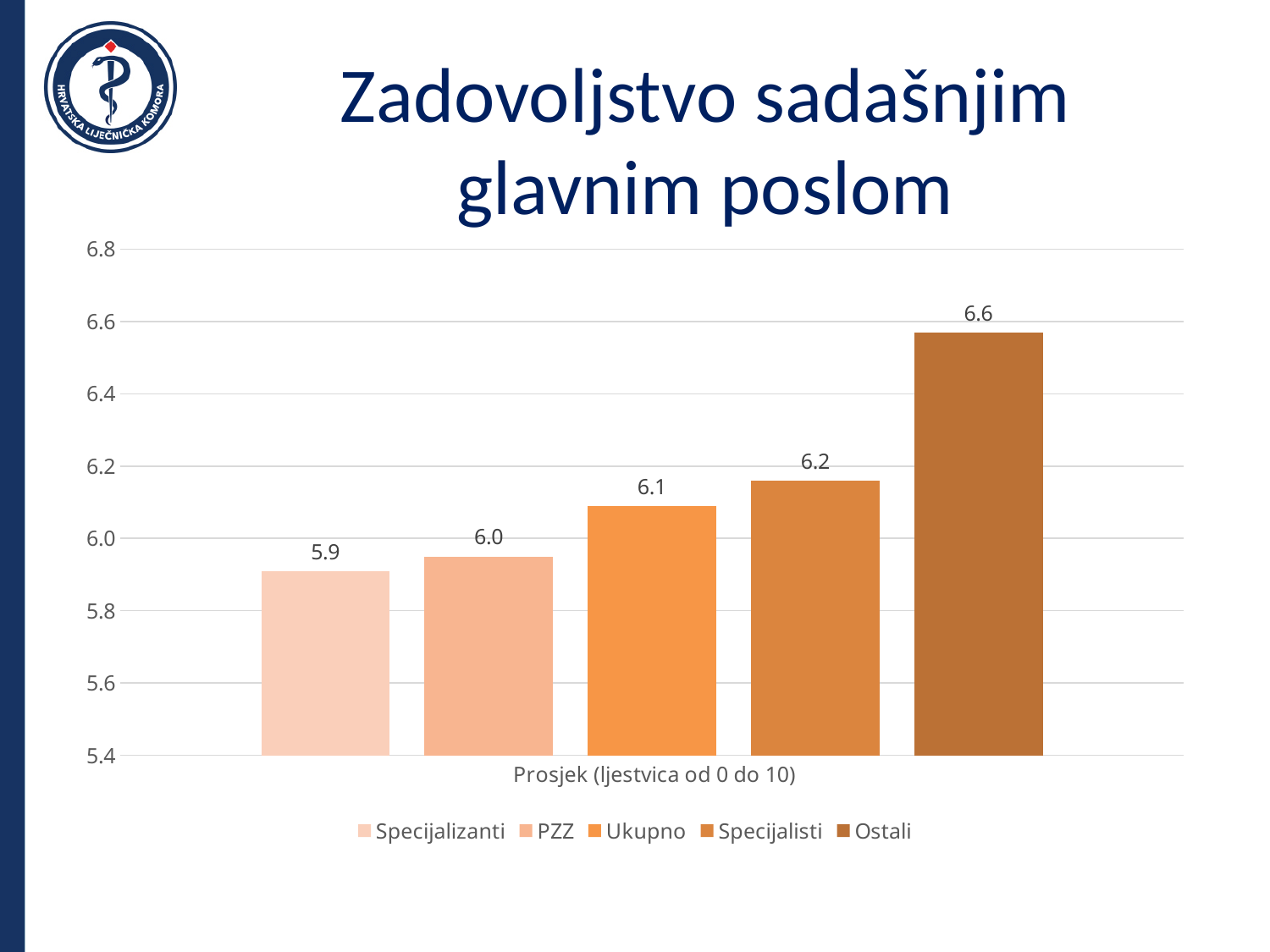
Which group has the lowest value? Specijalizanti What is the value for Ostali? 6.6 What is the value for Specijalizanti? 5.9 Is the value for Ostali greater or less than 6.4? greater How many series does the legend list? 5 What is the title of the chart? Zadovoljstvo sadašnjim glavnim poslom What is the difference between the values for Ostali and Specijalizanti? 0.7 What is the value for Specijalisti? 6.2 What kind of chart is shown on the slide? bar chart Which group has the highest value? Ostali Which is larger, the value for Specijalisti or the value for PZZ? Specijalisti What is the value for Ukupno? 6.1